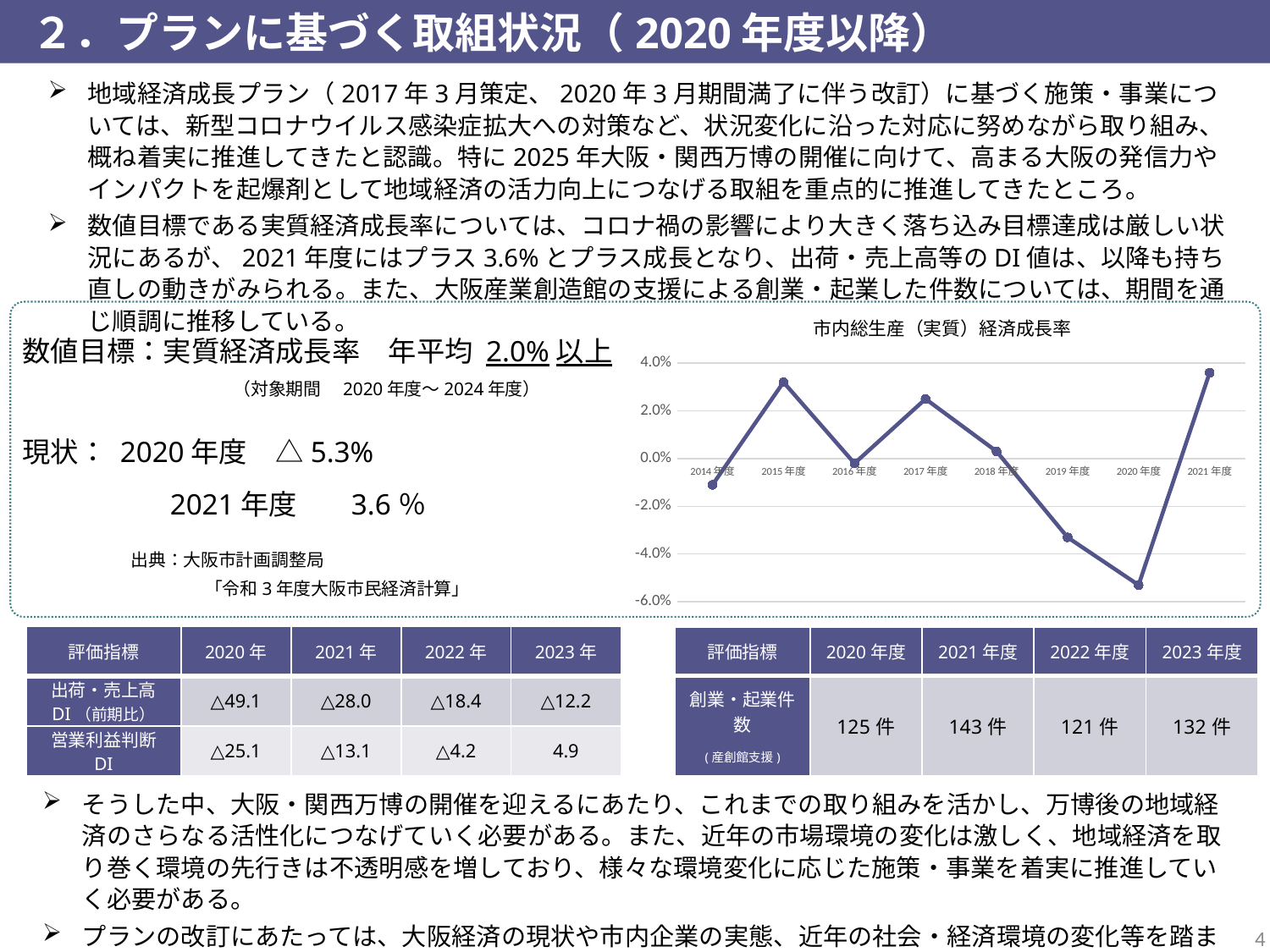
What kind of chart is the 市内総生産（実質）経済成長率 chart? line chart On the 市内総生産（実質）経済成長率 chart, which is higher, the value for 2015年度 or 2017年度? 2015年度 How many fiscal years are plotted on the 市内総生産（実質）経済成長率 chart? 8 On the 市内総生産（実質）経済成長率 chart, is the value for 2015年度 greater or less than 2.0%? greater On the 市内総生産（実質）経済成長率 chart, is the value for 2019年度 greater or less than -2.0%? less Which fiscal year has the lowest value on the 市内総生産（実質）経済成長率 chart? 2020年度 On the 市内総生産（実質）経済成長率 chart, is the value for 2020年度 greater or less than -4.0%? less On the 市内総生産（実質）経済成長率 chart, which is lower, the value for 2019年度 or 2020年度? 2020年度 Which fiscal year has the highest value on the 市内総生産（実質）経済成長率 chart? 2021年度 What is the title of the chart on the slide? 市内総生産（実質）経済成長率 On the 市内総生産（実質）経済成長率 chart, do the values rise or fall from 2017年度 to 2020年度? fall